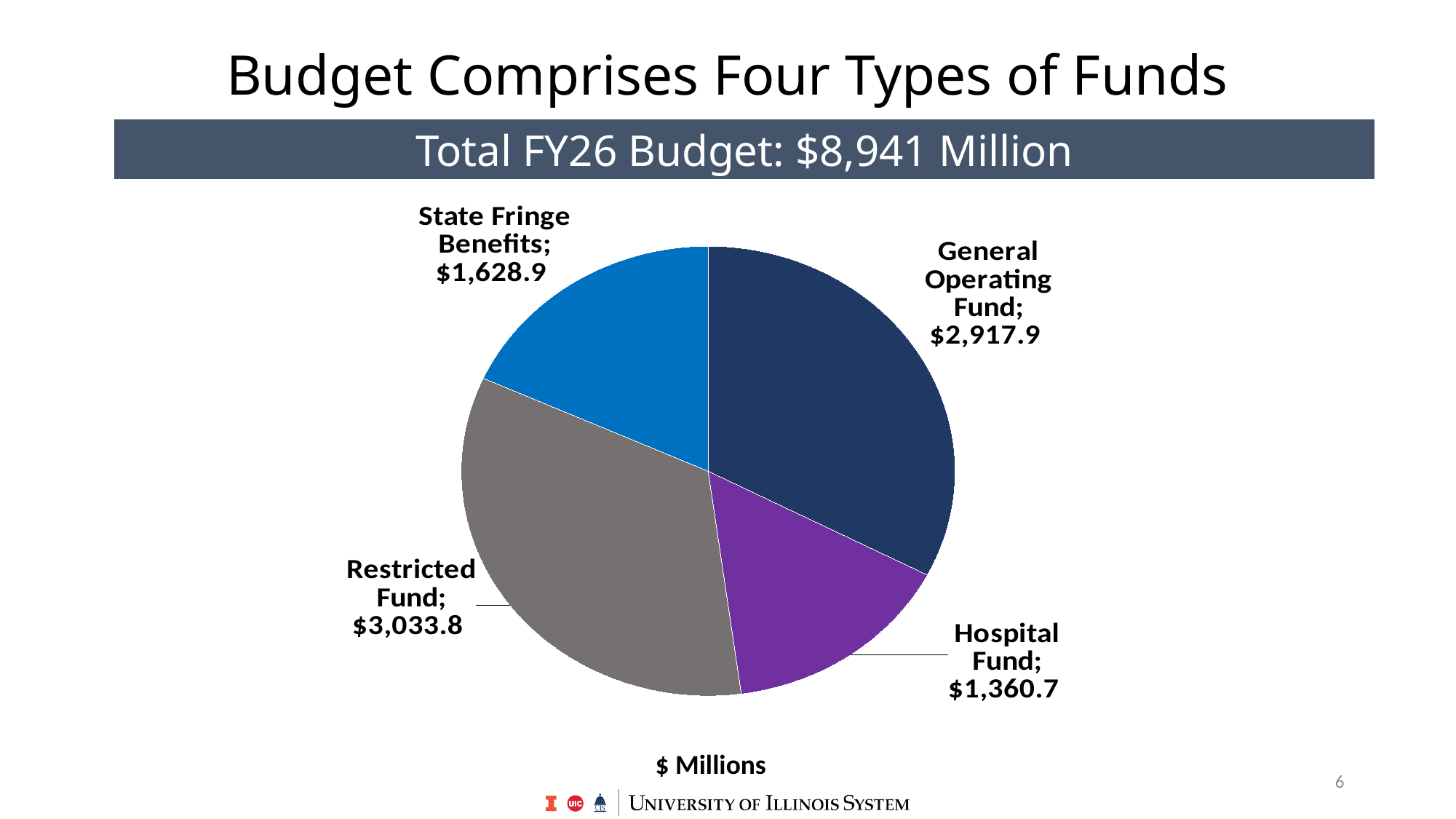
What is the value shown for the General Operating Fund? $2,917.9 Which fund type has the largest value in the pie chart? Restricted Fund Which fund type has the smallest value in the pie chart? Hospital Fund How many fund types (slices) does the pie chart show? 4 What is the value shown for the Restricted Fund? $3,033.8 What type of chart is shown on the slide? Pie chart What is the value shown for State Fringe Benefits? $1,628.9 What is the difference between the Restricted Fund and the General Operating Fund values? $115.9 What is the total FY26 budget stated on the slide? $8,941 Million In what units are the pie chart values expressed? $ Millions What is the value shown for the Hospital Fund? $1,360.7 Which is larger, State Fringe Benefits or the Hospital Fund? State Fringe Benefits